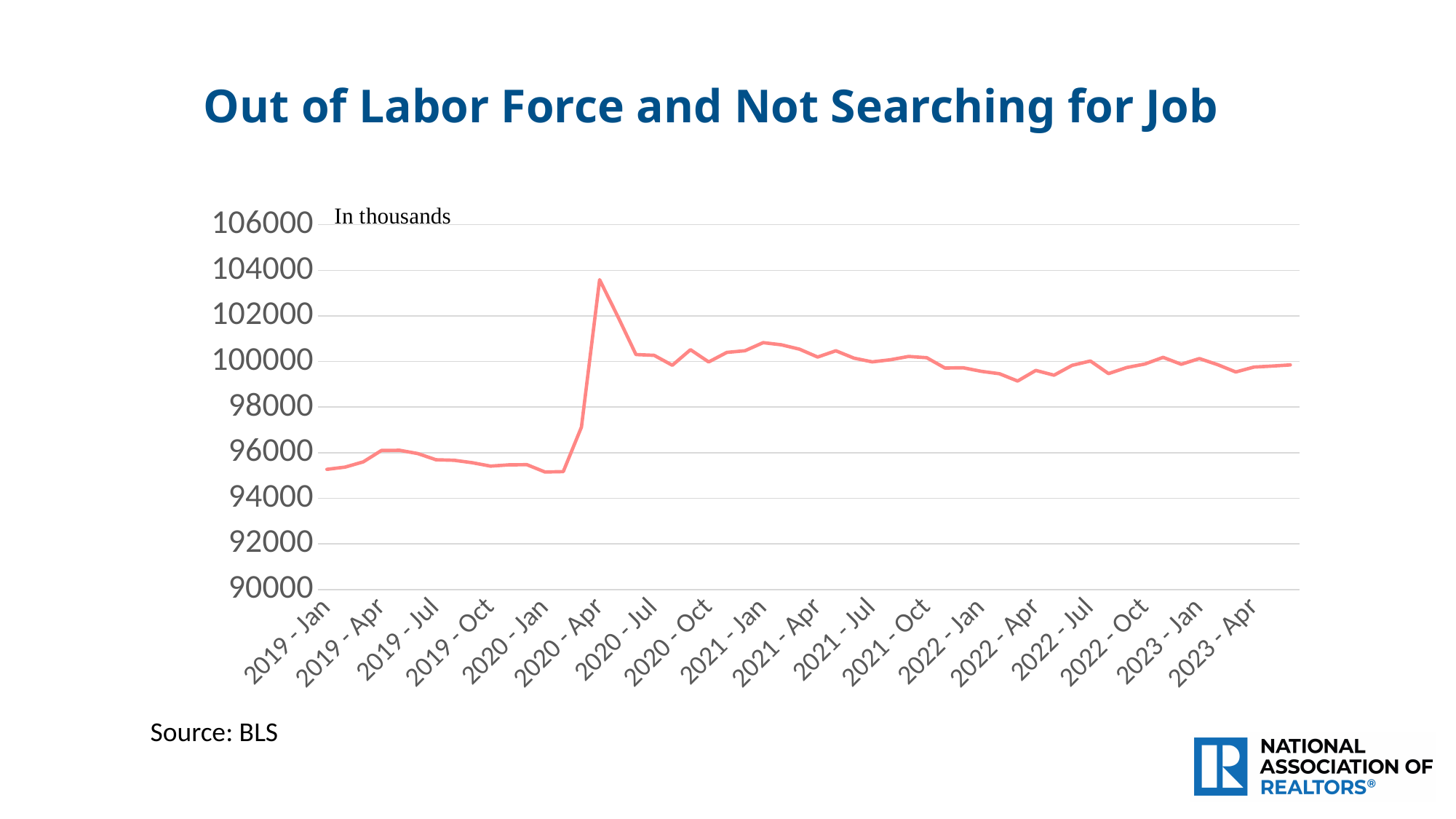
How many lines (series) are plotted on the chart? 1 What kind of chart is shown on the slide? line chart Does the line rise or fall between 2020 - Jan and 2020 - Apr? rise What unit does the chart say the values are in? In thousands Is the value for 2020 - Apr greater or less than 102000? greater At which x-axis date does the line reach its highest value? 2020 - Apr Is the value for 2019 - Jan greater or less than 96000? less How many date labels are shown on the x axis? 18 Which is larger, the value for 2020 - Apr or the value for 2019 - Oct? 2020 - Apr Is the value for 2022 - Apr greater or less than 100000? less What is the title of the chart? Out of Labor Force and Not Searching for Job